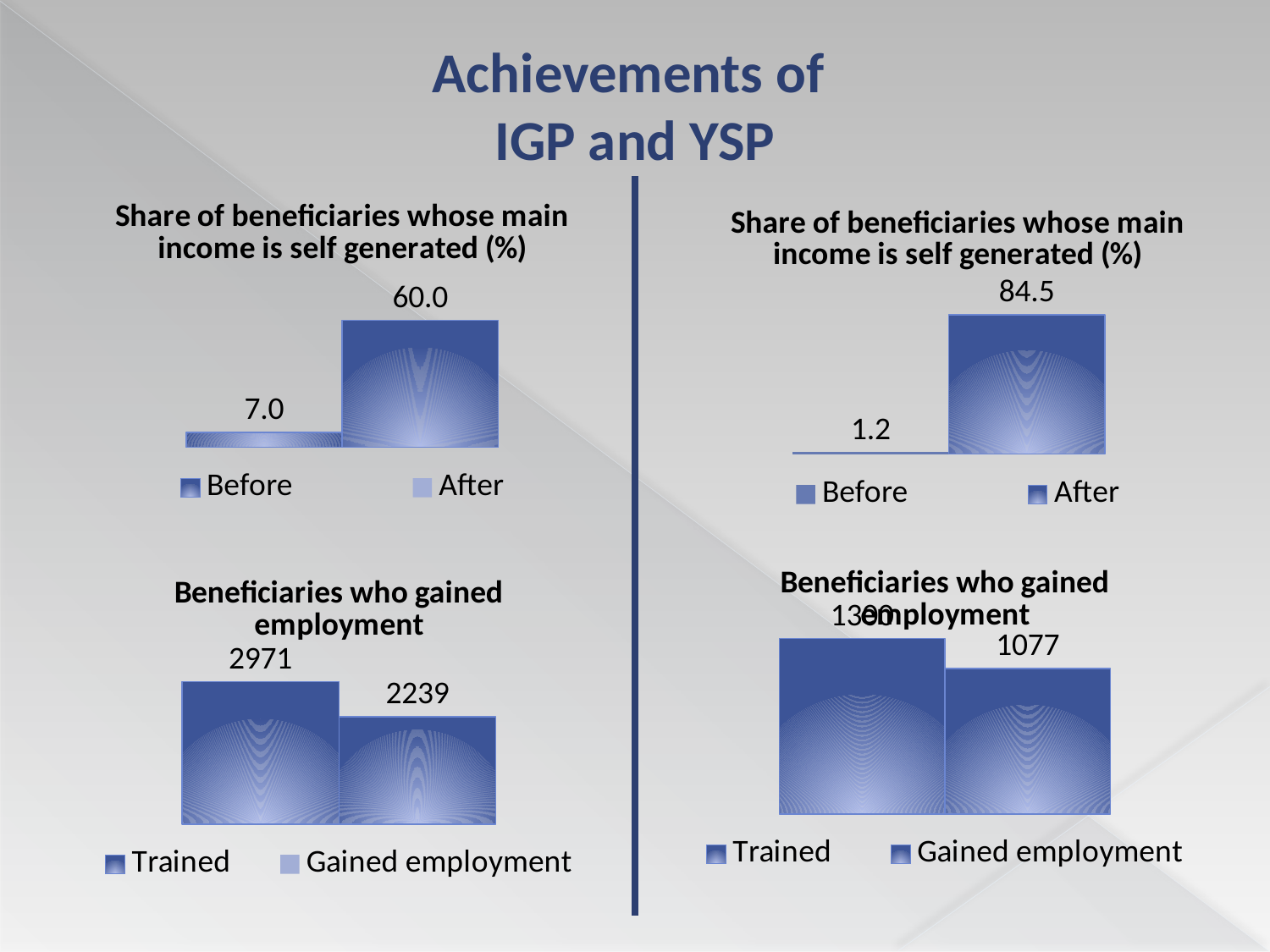
In the top-left chart, what is the difference between the After and Before values? 53.0 In the top-right chart, which is larger, Before or After? After In the top-left chart, what is the value for After? 60.0 In the top-right chart, what is the value for Before? 1.2 In the bottom-right chart, what is the value for Gained employment? 1077 In the top-left chart, what is the value for Before? 7.0 In the bottom-left chart, how many beneficiaries Gained employment? 2239 In the bottom-left chart, what is the difference between Trained and Gained employment? 732 What kind of chart is the bottom-left chart? Bar chart In the bottom-right chart, which is larger, Trained or Gained employment? Trained In the bottom-left chart, how many beneficiaries were Trained? 2971 In the top-right chart, what is the value for After? 84.5